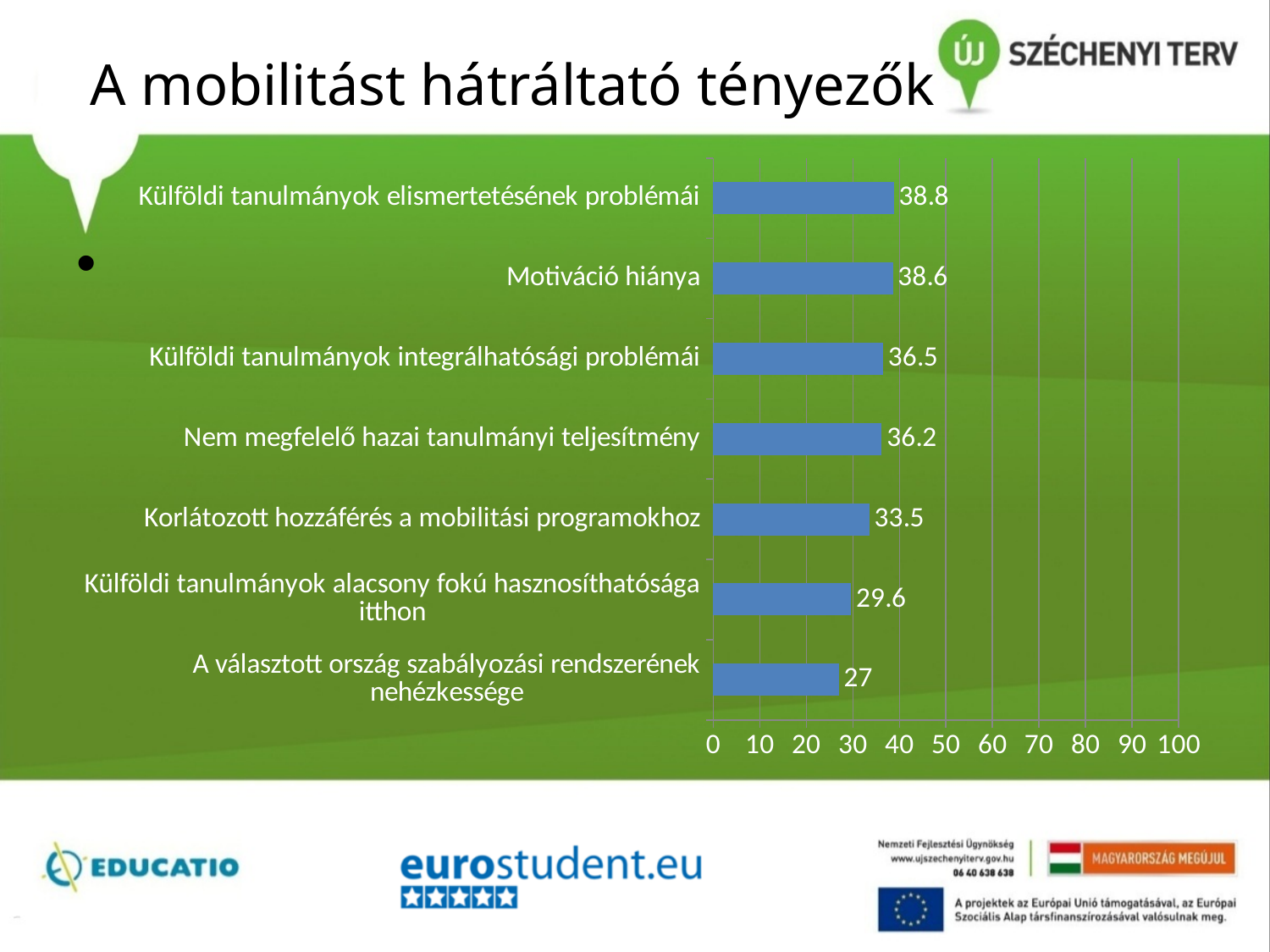
What is the value for "Motiváció hiánya"? 38.6 What is the difference between the values for "Külföldi tanulmányok integrálhatósági problémái" and "Nem megfelelő hazai tanulmányi teljesítmény"? 0.3 Which is larger: the value for "Korlátozott hozzáférés a mobilitási programokhoz" or for "Külföldi tanulmányok alacsony fokú hasznosíthatósága itthon"? Korlátozott hozzáférés a mobilitási programokhoz What is the value for "Korlátozott hozzáférés a mobilitási programokhoz"? 33.5 What kind of chart is shown on the slide? Bar chart Which category has the highest value? Külföldi tanulmányok elismertetésének problémái Which category has the lowest value? A választott ország szabályozási rendszerének nehézkessége What is the value for "A választott ország szabályozási rendszerének nehézkessége"? 27 How many categories are shown in the chart? 7 What is the maximum value shown on the horizontal axis? 100 What is the value for "Külföldi tanulmányok alacsony fokú hasznosíthatósága itthon"? 29.6 What is the difference between the highest and lowest values in the chart? 11.8